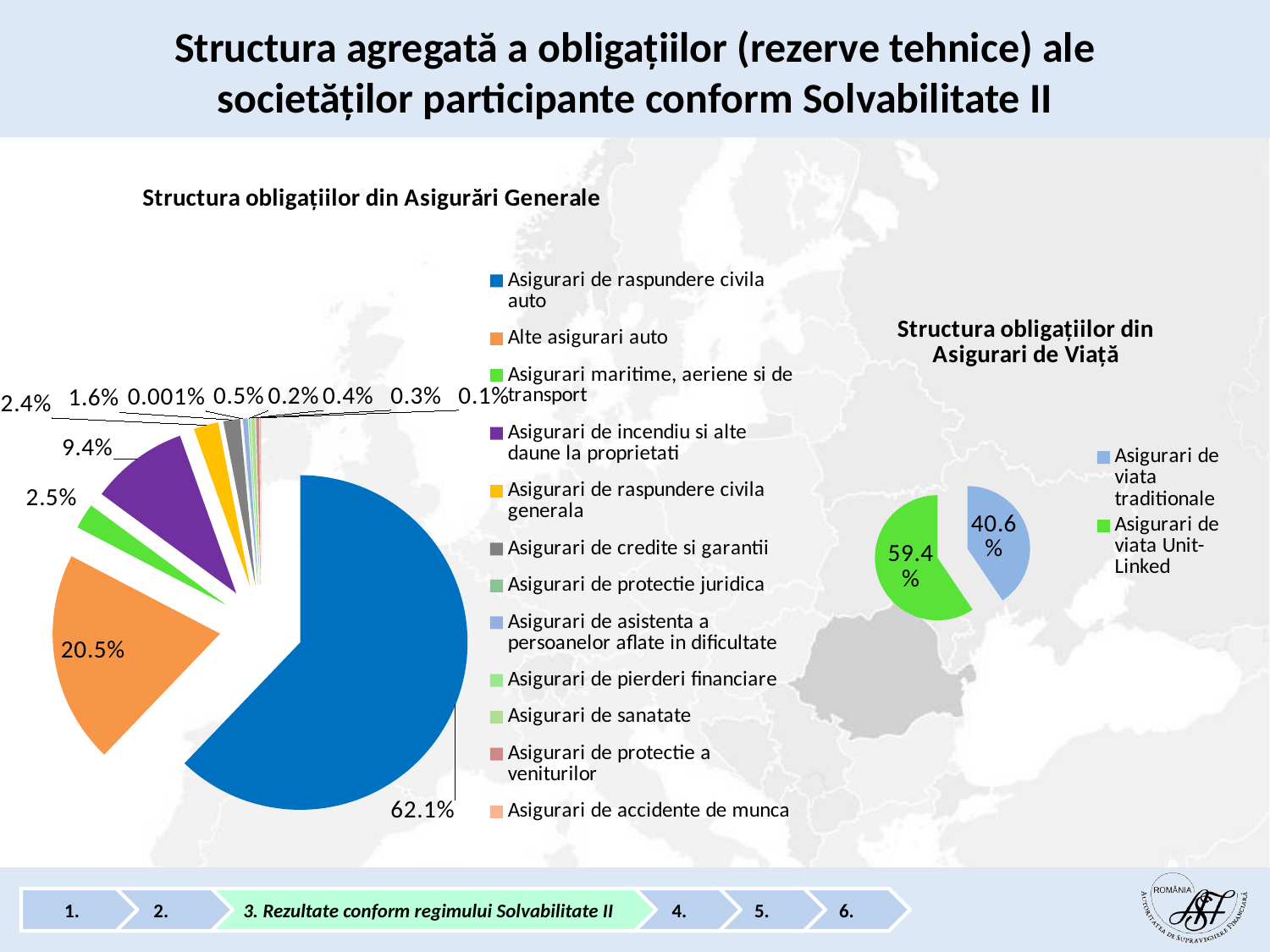
In the chart 'Structura obligațiilor din Asigurări Generale', which is larger: 'Asigurari de incendiu si alte daune la proprietati' or 'Asigurari maritime, aeriene si de transport'? Asigurari de incendiu si alte daune la proprietati In the chart 'Structura obligațiilor din Asigurări Generale', which category has the largest share? Asigurari de raspundere civila auto What type of chart is 'Structura obligațiilor din Asigurări Generale'? Pie chart How many categories does the legend of the chart 'Structura obligațiilor din Asigurări Generale' list? 12 In the chart 'Structura obligațiilor din Asigurari de Viață', what is the difference between the Unit-Linked and traditional life insurance shares? 18.8 percentage points In the chart 'Structura obligațiilor din Asigurari de Viață', what share is shown for 'Asigurari de viata Unit-Linked'? 59.4% In the chart 'Structura obligațiilor din Asigurări Generale', what share is shown for 'Asigurari de raspundere civila auto'? 62.1% In the chart 'Structura obligațiilor din Asigurari de Viață', what share is shown for 'Asigurari de viata traditionale'? 40.6% In the chart 'Structura obligațiilor din Asigurări Generale', what share is shown for 'Alte asigurari auto'? 20.5% In the chart 'Structura obligațiilor din Asigurări Generale', what is the difference between the shares of 'Asigurari de raspundere civila auto' and 'Alte asigurari auto'? 41.6 percentage points How many categories does the legend of the chart 'Structura obligațiilor din Asigurari de Viață' list? 2 In the chart 'Structura obligațiilor din Asigurări Generale', what share is shown for 'Asigurari de incendiu si alte daune la proprietati'? 9.4%